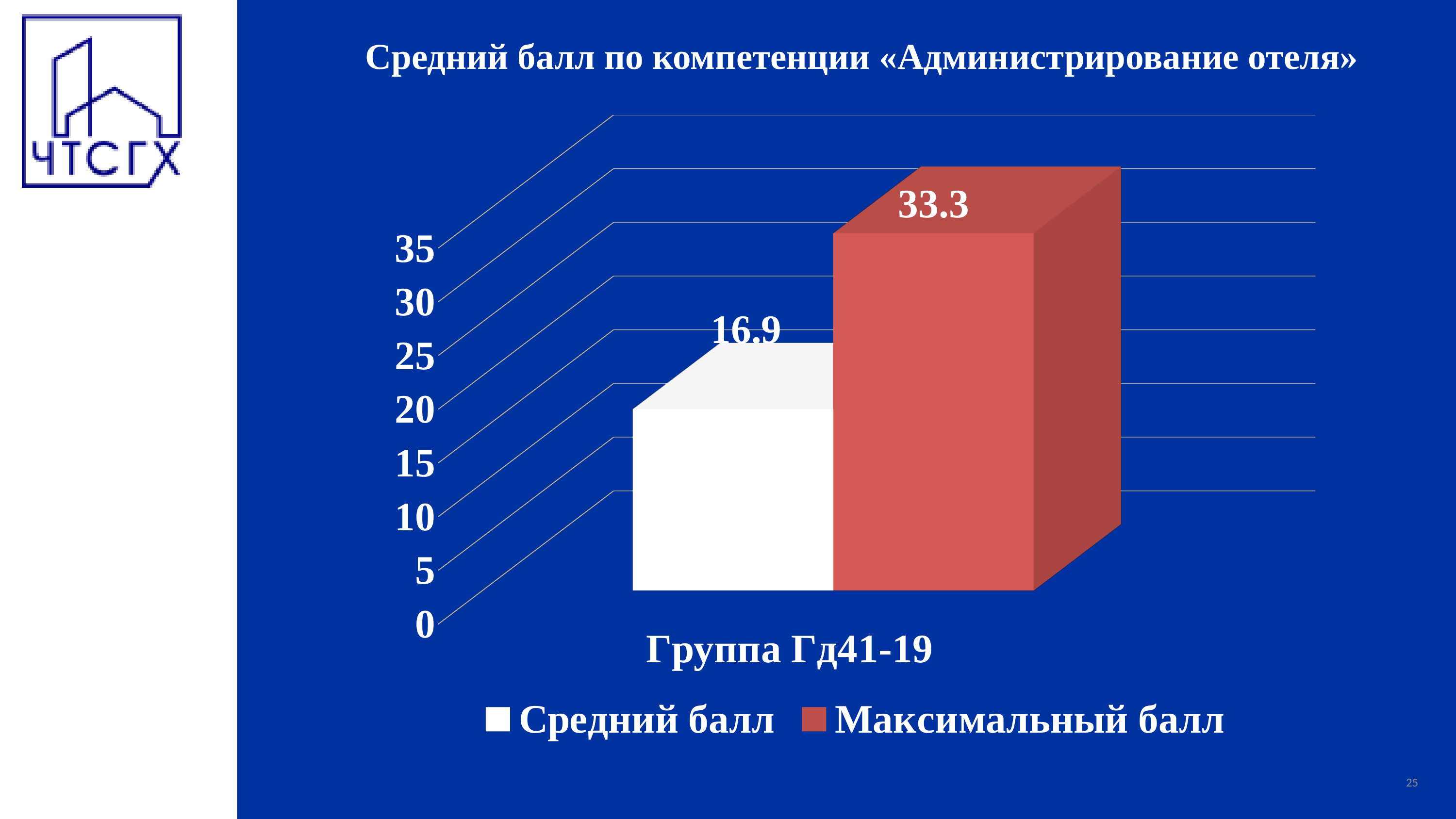
How many series does the legend list? 2 What colour is the bar for "Максимальный балл"? Red What is the category label on the x axis? Группа Гд41-19 What is the title of the chart? Средний балл по компетенции «Администрирование отеля» What is the value of "Средний балл" for Группа Гд41-19? 16.9 What kind of chart is shown on the slide? Bar chart Is the value of "Средний балл" for Группа Гд41-19 greater or less than 20? less Which series has the higher value for Группа Гд41-19, "Средний балл" or "Максимальный балл"? Максимальный балл Is the value of "Максимальный балл" for Группа Гд41-19 greater or less than 30? greater What is the difference between "Максимальный балл" and "Средний балл" for Группа Гд41-19? 16.4 How many categories are shown on the x axis? 1 What is the value of "Максимальный балл" for Группа Гд41-19? 33.3